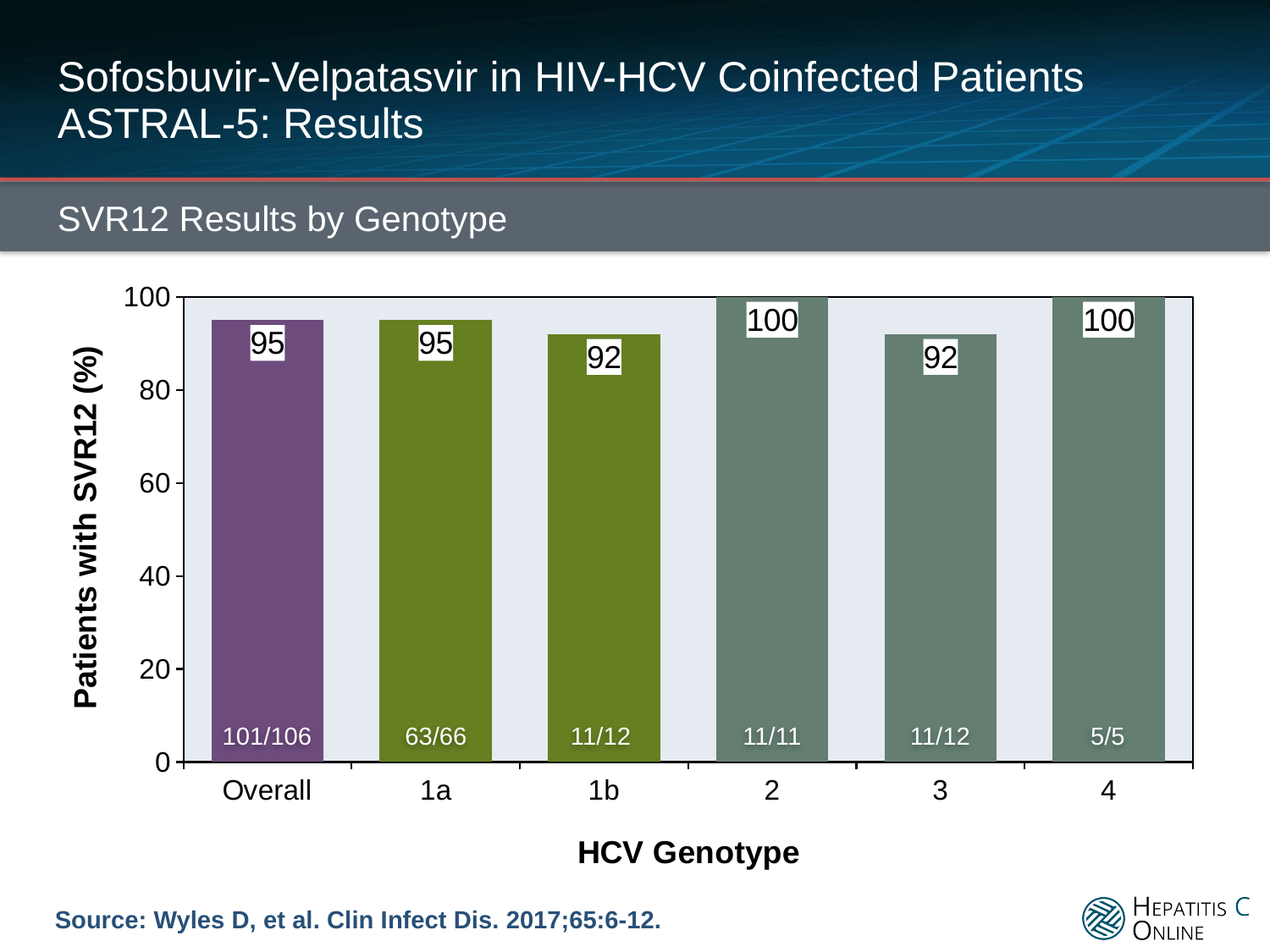
What is the label of the x axis? HCV Genotype Which has a higher SVR12 rate, genotype 1a or genotype 1b? 1a How many bars are shown in the chart? 6 What type of chart is shown on the slide? Bar chart What fraction of patients is shown at the base of the genotype 1a bar? 63/66 What is the SVR12 rate for genotype 1b? 92 What is the SVR12 rate for the Overall group? 95 Which genotypes have the highest SVR12 rate? 2 and 4 Which genotypes have the lowest SVR12 rate? 1b and 3 What fraction of patients is shown at the base of the Overall bar? 101/106 What is the difference in SVR12 rate between genotype 2 and genotype 3? 8 What is the SVR12 rate for genotype 2? 100